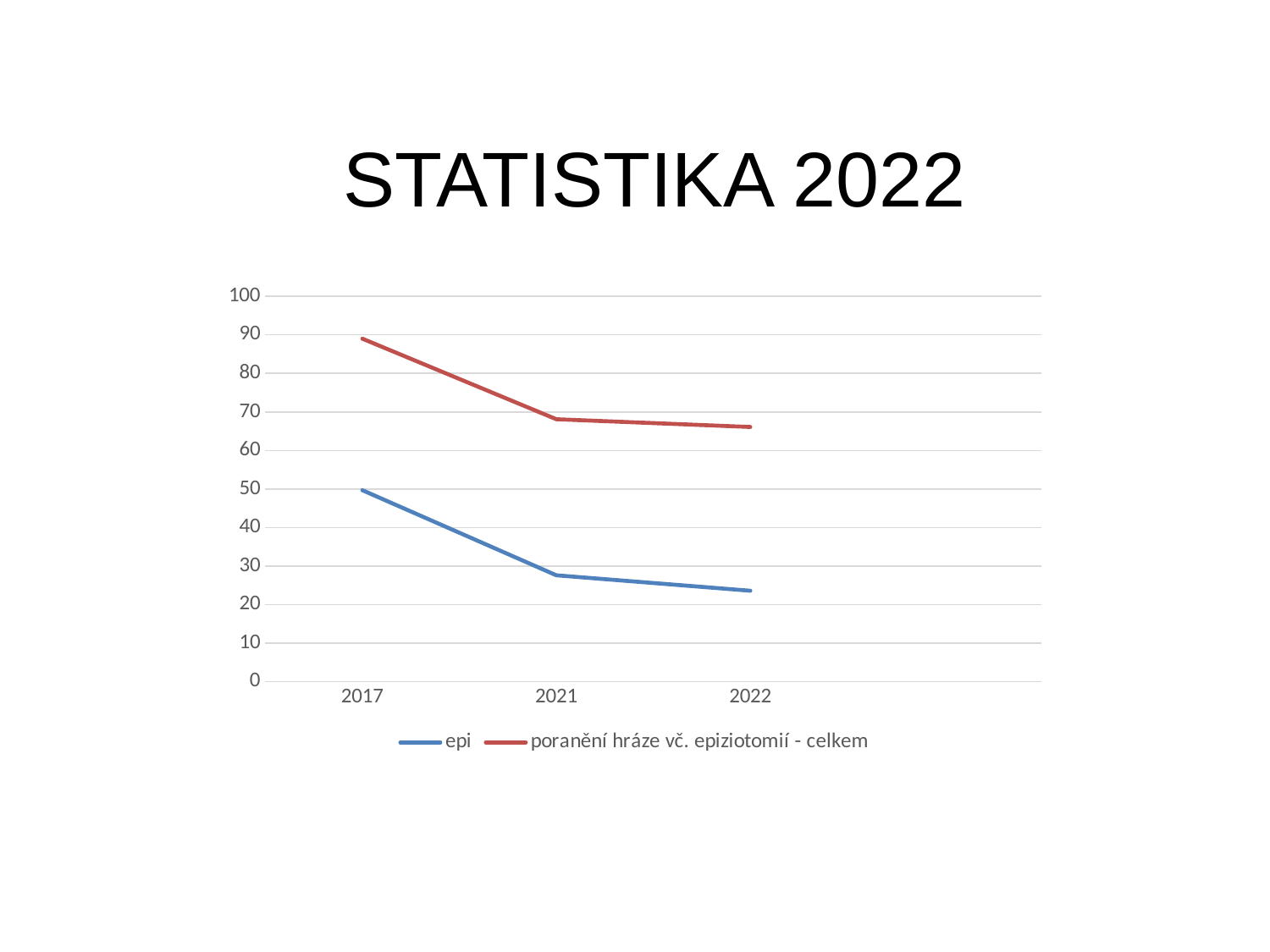
What kind of chart is shown on the slide? line chart Does the 'epi' series rise or fall from 2017 to 2022? fall Is the value for 'epi' in 2021 greater or less than 30? less Does the 'poranění hráze vč. epiziotomií - celkem' series rise or fall from 2017 to 2022? fall In which year is the 'epi' series highest? 2017 Is the value for 'poranění hráze vč. epiziotomií - celkem' in 2017 greater or less than 80? greater In which year is the 'poranění hráze vč. epiziotomií - celkem' series highest? 2017 How many years are plotted along the x axis? 3 What is the title of the slide above the chart? STATISTIKA 2022 In 2021, which series has the larger value, 'epi' or 'poranění hráze vč. epiziotomií - celkem'? poranění hráze vč. epiziotomií - celkem How many series does the legend list? 2 In which year is the 'epi' series lowest? 2022